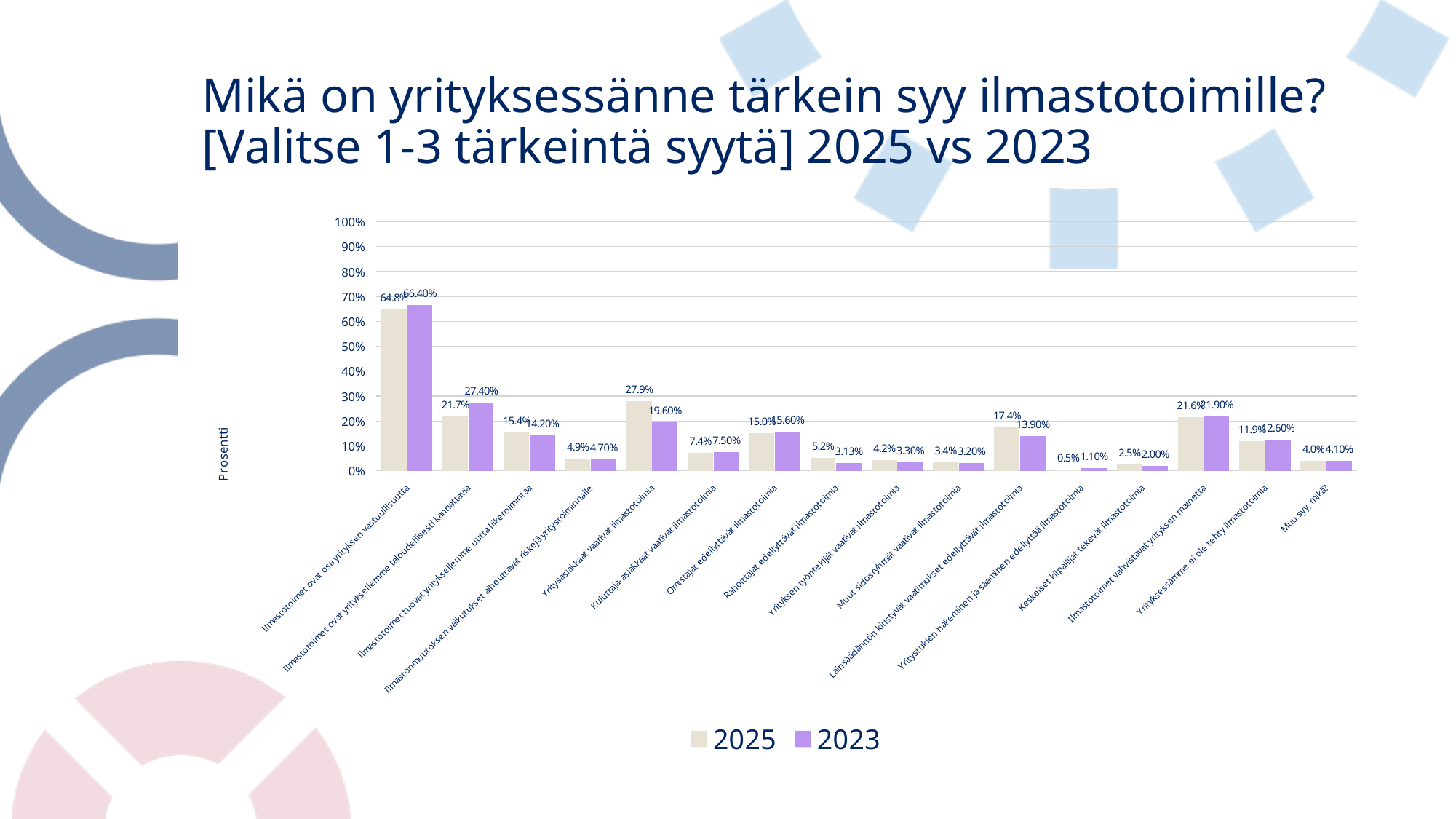
How many series does the legend list? 2 What is the difference between the 2023 and 2025 values for "Ilmastotoimet ovat yrityksellemme taloudellisesti kannattavia"? 5.7% Which category has the lowest 2025 value? Yritystukien hakeminen ja saaminen edellyttää ilmastotoimia What is the 2025 value for "Lainsäädännön kiristyvät vaatimukset edellyttävät ilmastotoimia"? 17.4% What is the 2023 value for "Ilmastotoimet ovat yrityksellemme taloudellisesti kannattavia"? 27.40% For "Rahoittajat edellyttävät ilmastotoimia", which year has the larger value, 2025 or 2023? 2025 What kind of chart is shown on the slide? Bar chart What is the difference between the 2025 and 2023 values for "Yritysasiakkaat vaativat ilmastotoimia"? 8.3% What is the 2025 value for "Yritysasiakkaat vaativat ilmastotoimia"? 27.9% Is the 2025 value for "Ilmastotoimet ovat osa yrityksen vastuullisuutta" greater or less than 60%? greater Which category has the highest 2025 value? Ilmastotoimet ovat osa yrityksen vastuullisuutta How many categories are shown on the x axis? 16